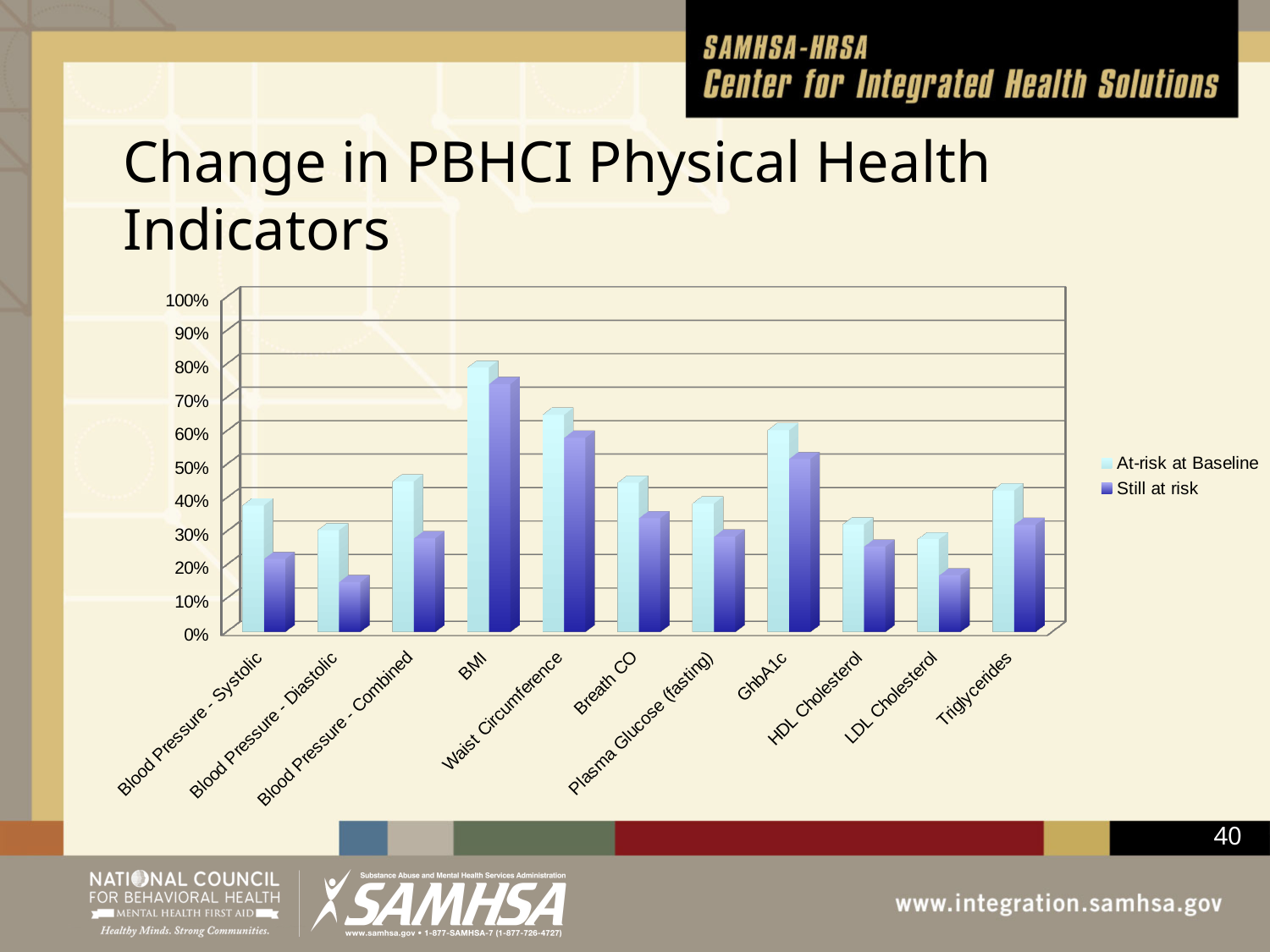
Which is larger: the At-risk at Baseline value for Blood Pressure - Combined or for Blood Pressure - Diastolic? Blood Pressure - Combined Which indicator has the highest At-risk at Baseline value? BMI Is the At-risk at Baseline value for GhbA1c greater or less than 50%? greater Is the At-risk at Baseline value for BMI greater or less than 70%? greater Is the Still at risk value for Waist Circumference greater or less than 50%? greater For every indicator, which series has the taller bar: At-risk at Baseline or Still at risk? At-risk at Baseline What kind of chart is shown on the slide? Bar chart How many health indicator categories are shown on the x axis? 11 What are the two series named in the legend? At-risk at Baseline; Still at risk Which indicator has the highest Still at risk value? BMI How many series does the legend list? 2